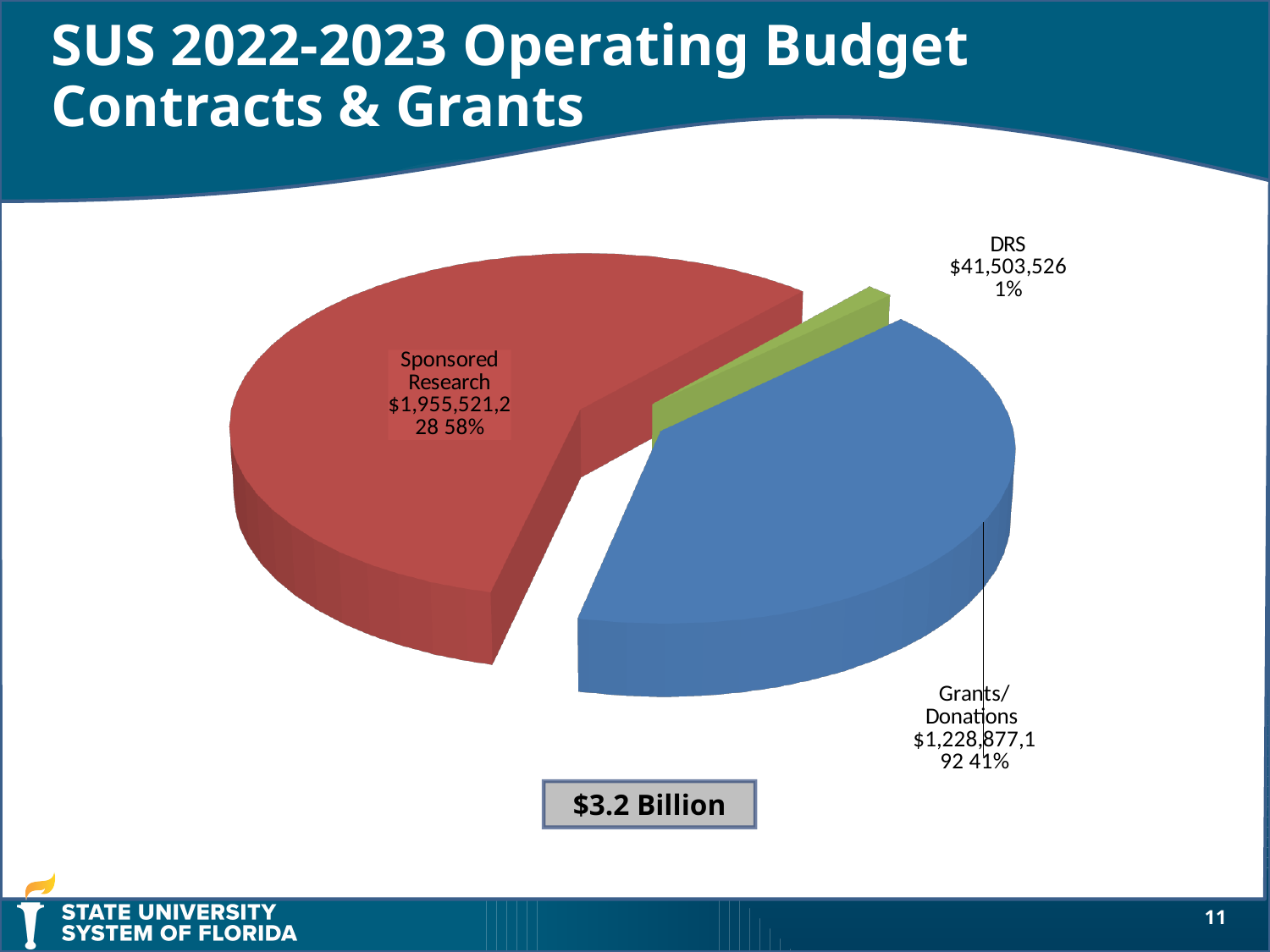
Which is larger, Sponsored Research or Grants/Donations? Sponsored Research What kind of chart is shown on the slide? pie chart What is the value shown for Grants/Donations? $1,228,877,192 What percentage share of the pie is Grants/Donations? 41% What percentage share of the pie is DRS? 1% What total amount is shown in the box below the pie chart? $3.2 Billion How many slices does the pie chart have? 3 Which category has the largest slice of the pie? Sponsored Research Which category has the smallest slice of the pie? DRS What is the value shown for DRS? $41,503,526 What is the value shown for Sponsored Research? $1,955,521,228 What percentage share of the pie is Sponsored Research? 58%